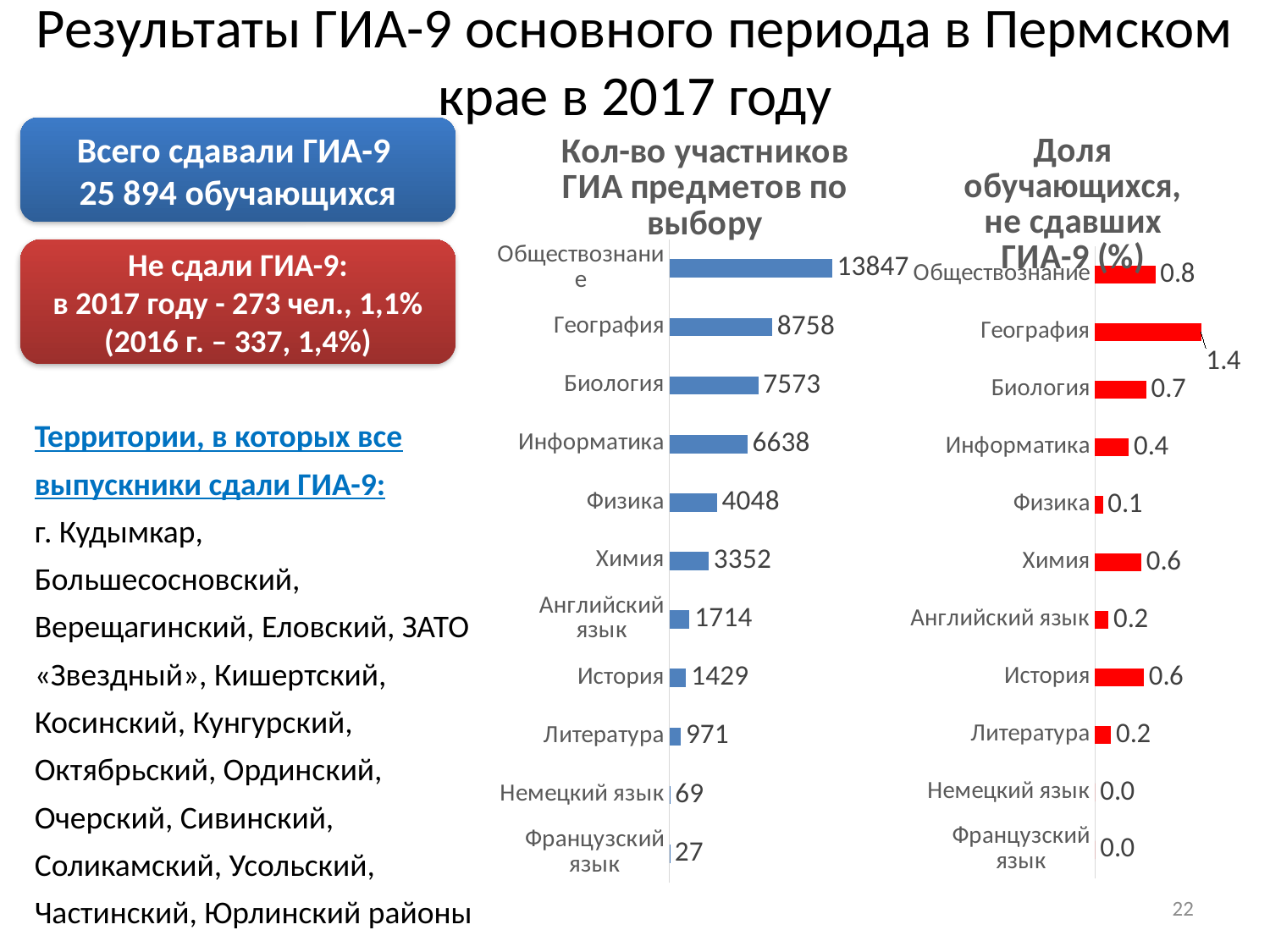
In the chart 'Кол-во участников ГИА предметов по выбору', which subject has the lowest number of participants? Французский язык In the chart 'Кол-во участников ГИА предметов по выбору', what is the difference between the number of participants for География and Биология? 1185 In the chart 'Кол-во участников ГИА предметов по выбору', which subject has the highest number of participants? Обществознание What type of chart is 'Кол-во участников ГИА предметов по выбору'? Bar chart In the chart 'Доля обучающихся, не сдавших ГИА-9 (%)', which subject has the highest share of students who failed? География In the chart 'Доля обучающихся, не сдавших ГИА-9 (%)', what is the difference between the values for География and Физика? 1.3 In the chart 'Кол-во участников ГИА предметов по выбору', how many participants took Немецкий язык? 69 In the chart 'Кол-во участников ГИА предметов по выбору', how many subjects are shown? 11 In the chart 'Доля обучающихся, не сдавших ГИА-9 (%)', which is larger, the value for Обществознание or the value for Биология? Обществознание In the chart 'Доля обучающихся, не сдавших ГИА-9 (%)', what is the value for География? 1.4 In the chart 'Кол-во участников ГИА предметов по выбору', how many participants took Биология? 7573 In the chart 'Доля обучающихся, не сдавших ГИА-9 (%)', what is the value for Информатика? 0.4